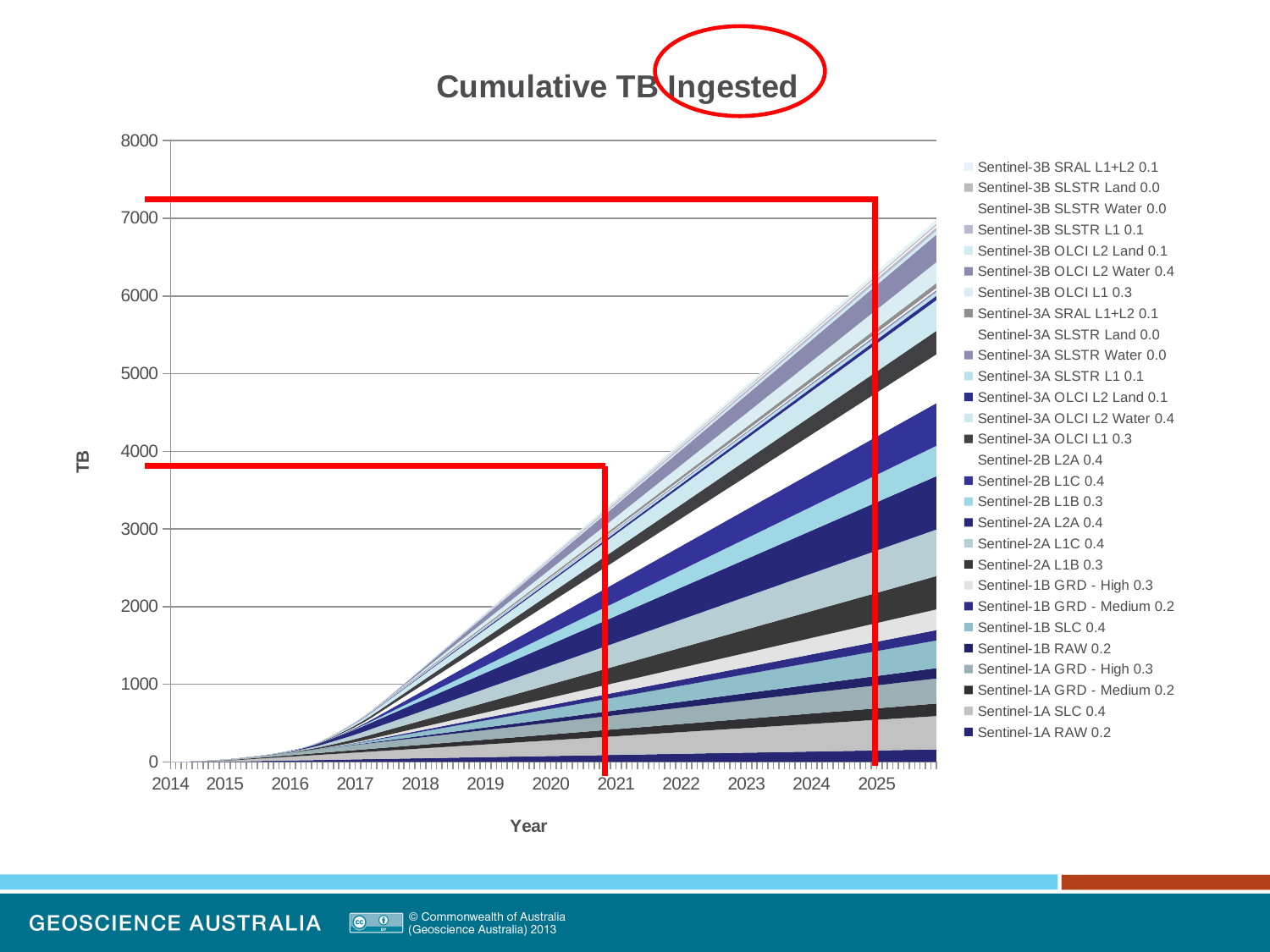
What is the title of the chart? Cumulative TB Ingested Does the cumulative total rise or fall from 2014 to 2025? rise Is the total cumulative TB ingested at 2020 greater or less than 1000? greater What kind of chart is shown on the slide? stacked area chart What is the label of the y axis? TB Is the total cumulative TB ingested at 2025 greater or less than 6000? greater Is the total cumulative TB ingested at 2021 greater or less than 4000? less Which year has the highest total cumulative TB ingested, 2021 or 2025? 2025 How many year labels are shown on the x axis? 12 How many series does the legend list? 28